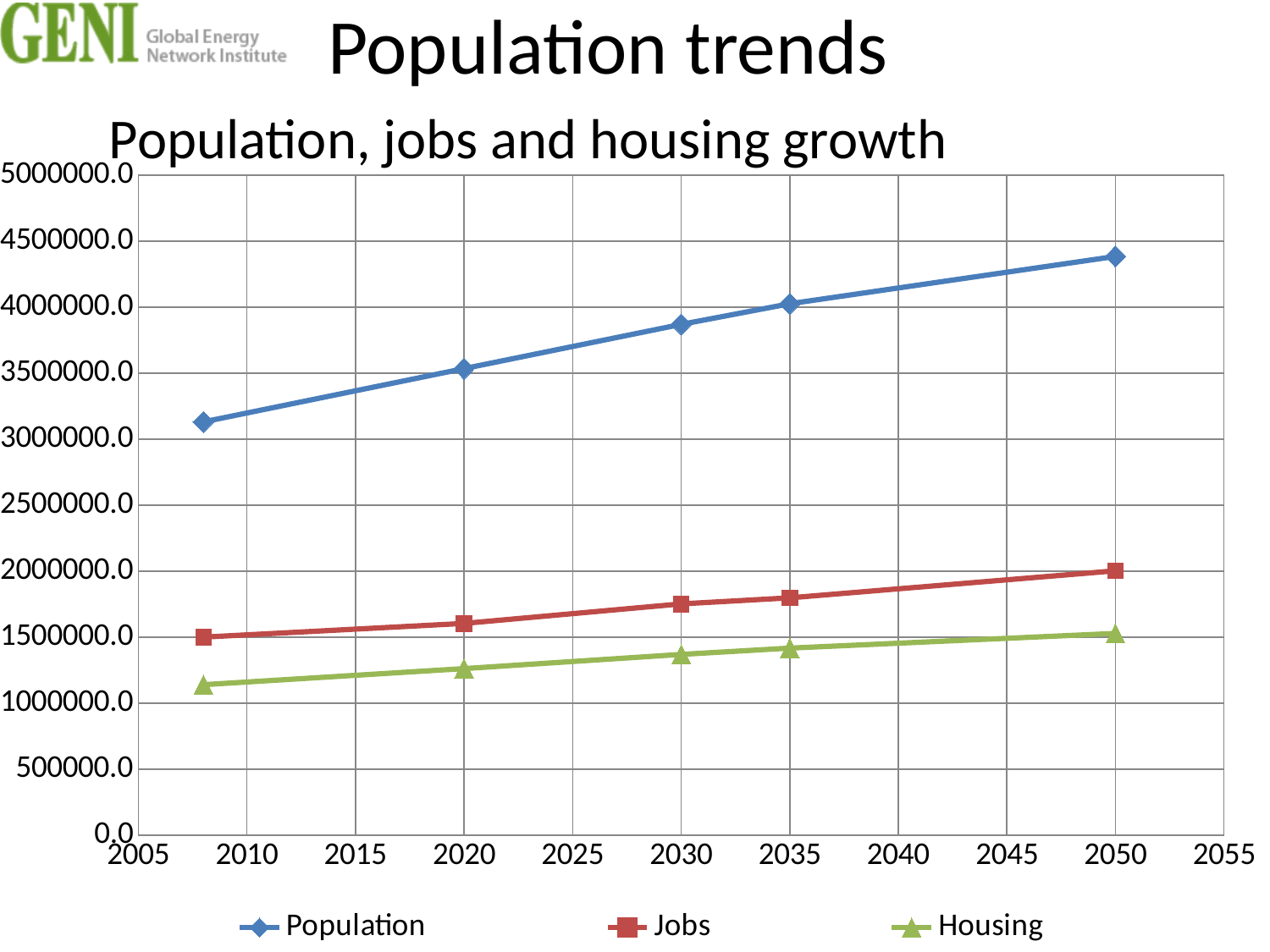
Is the Jobs value for 2030 greater or less than 1500000.0? greater How many series does the legend list? 3 Which series has the lowest values across all years? Housing What is the title of the chart? Population, jobs and housing growth How many data points are plotted for the Population series? 5 Do the Population values rise or fall from 2008 to 2050? rise Is the Population value for 2050 greater or less than 4000000.0? greater Is the Population value for 2030 greater or less than 4000000.0? less What kind of chart is shown on the slide? line chart In 2050, which is larger, the Jobs value or the Housing value? Jobs Which series has the highest values across all years? Population